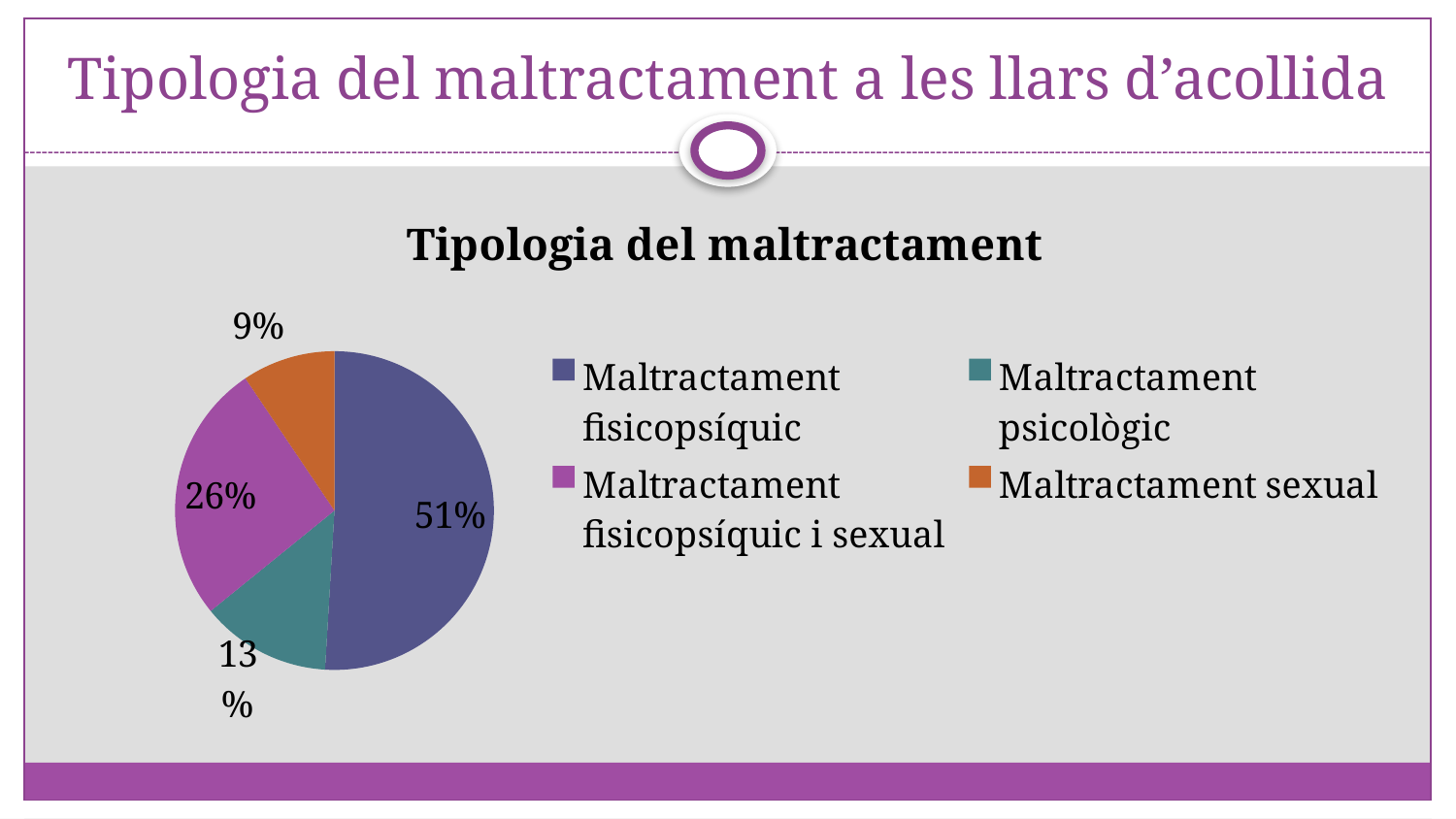
What is the title of the chart? Tipologia del maltractament What kind of chart is shown on the slide? Pie chart Which category has the smallest share of the pie? Maltractament sexual What colour is the slice for Maltractament sexual? Orange What is the difference in percentage points between Maltractament fisicopsíquic and Maltractament fisicopsíquic i sexual? 25 What percentage of the pie is Maltractament fisicopsíquic i sexual? 26% How many categories does the pie chart have? 4 What percentage of the pie is Maltractament fisicopsíquic? 51% Which is larger, the share for Maltractament psicològic or the share for Maltractament sexual? Maltractament psicològic Which category has the largest share of the pie? Maltractament fisicopsíquic What percentage of the pie is Maltractament psicològic? 13% What percentage of the pie is Maltractament sexual? 9%